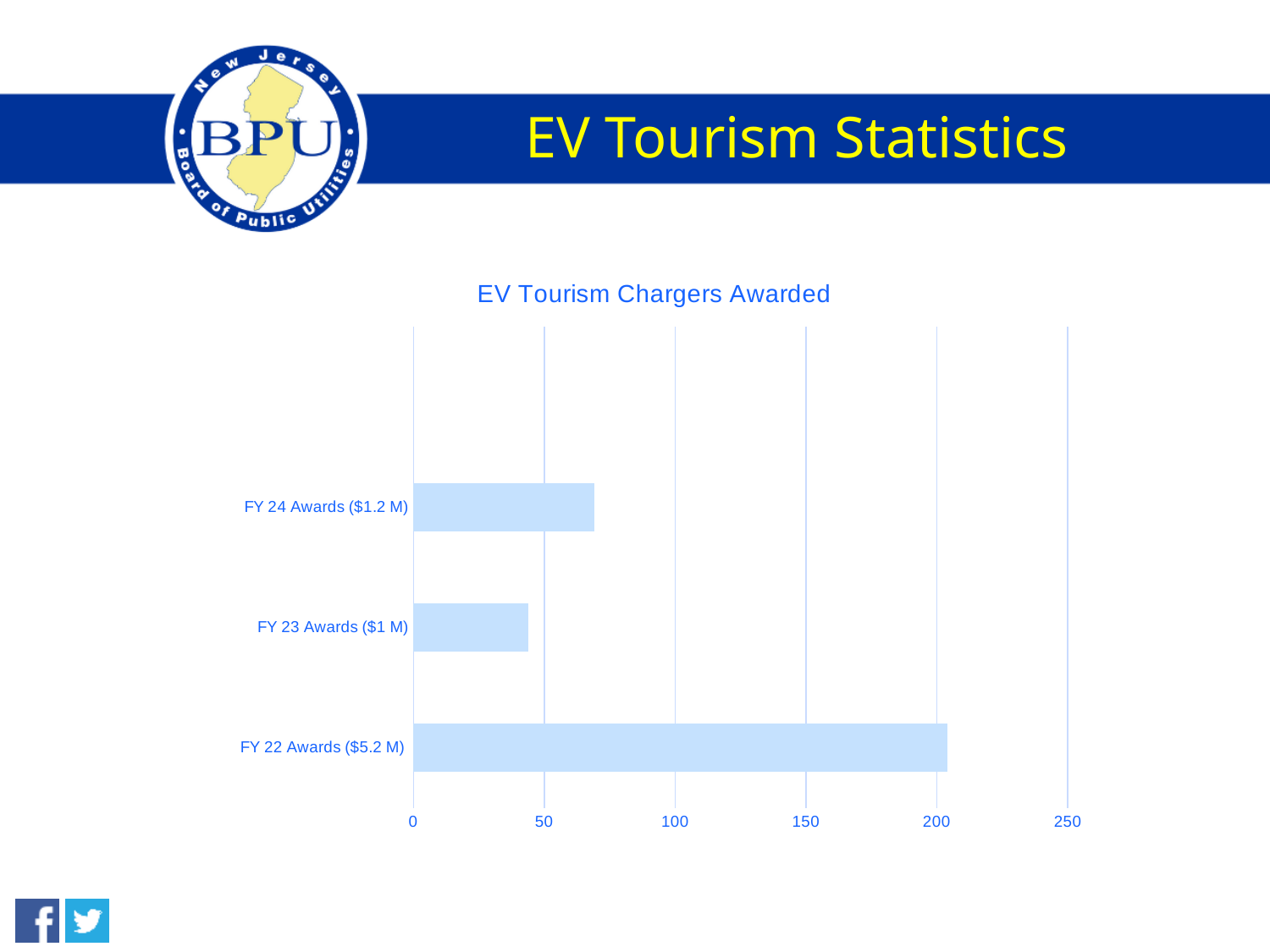
What is the highest value shown on the horizontal axis of the chart? 250 Is the value for FY 24 Awards ($1.2 M) greater or less than 50? greater Which is larger, the value for FY 24 Awards ($1.2 M) or FY 23 Awards ($1 M)? FY 24 Awards ($1.2 M) How many categories are plotted in the chart? 3 Is the value for FY 24 Awards ($1.2 M) greater or less than 100? less What is the title of the chart? EV Tourism Chargers Awarded Is the value for FY 23 Awards ($1 M) greater or less than 50? less Which category has the highest number of chargers awarded? FY 22 Awards ($5.2 M) Which is larger, the value for FY 22 Awards ($5.2 M) or FY 24 Awards ($1.2 M)? FY 22 Awards ($5.2 M) Which category has the lowest number of chargers awarded? FY 23 Awards ($1 M) What kind of chart is shown on the slide? Bar chart